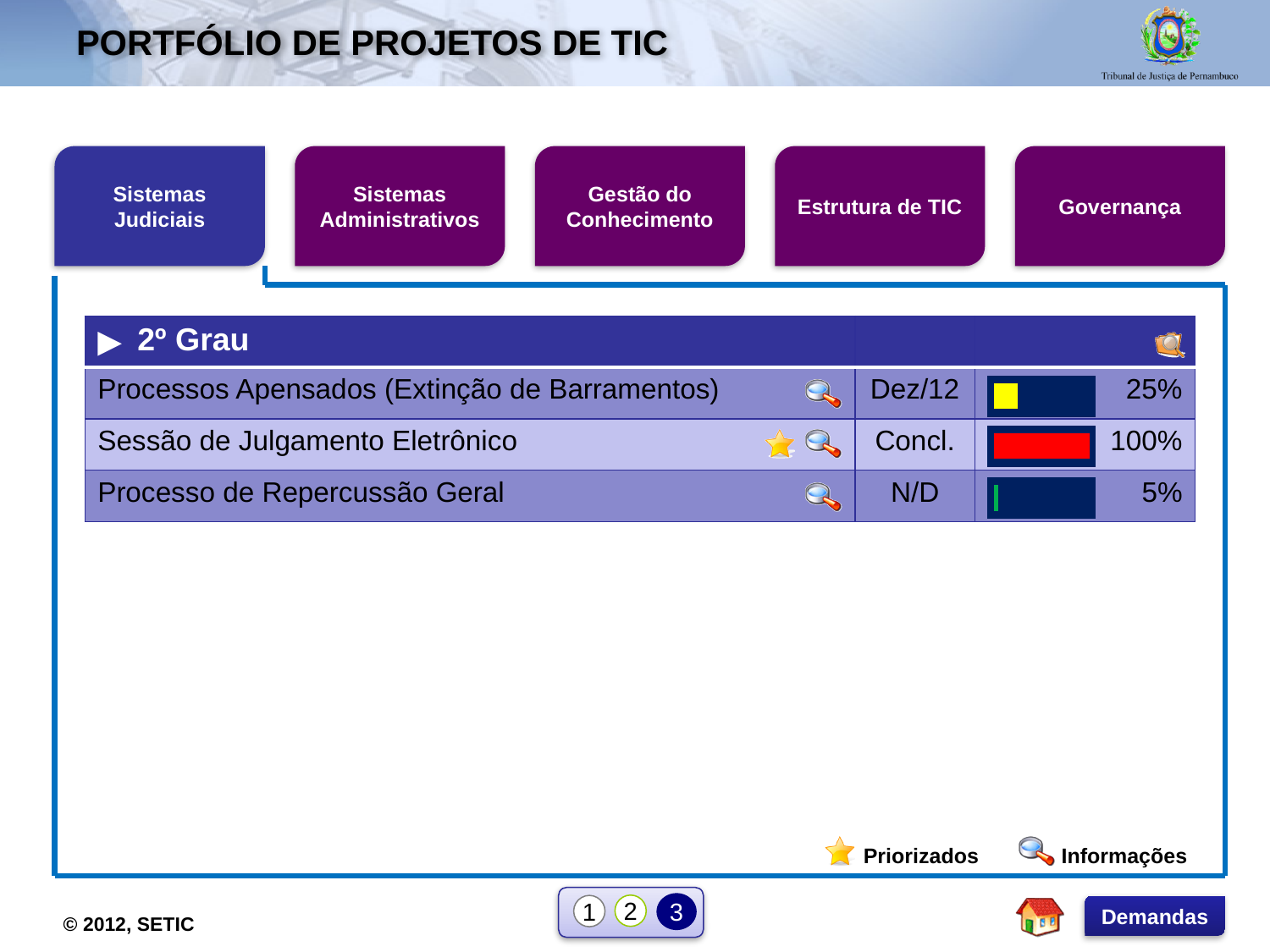
Which project in the 2º Grau table has the highest progress percentage? Sessão de Julgamento Eletrônico What is the difference in progress between Sessão de Julgamento Eletrônico and Processos Apensados (Extinção de Barramentos)? 75% How many projects are listed in the 2º Grau table? 3 Which has a higher progress percentage, Processos Apensados (Extinção de Barramentos) or Processo de Repercussão Geral? Processos Apensados (Extinção de Barramentos) Which project in the 2º Grau table has the lowest progress percentage? Processo de Repercussão Geral What is the progress percentage shown for Processo de Repercussão Geral? 5% What colour is the progress bar for Sessão de Julgamento Eletrônico? Red What is the difference in progress between Processos Apensados (Extinção de Barramentos) and Processo de Repercussão Geral? 20% What is the progress percentage shown for Processos Apensados (Extinção de Barramentos)? 25% What is the progress percentage shown for Sessão de Julgamento Eletrônico? 100% What deadline is shown for Processos Apensados (Extinção de Barramentos)? Dez/12 What kind of chart is used to show each project's progress in the 2º Grau table? Bar chart